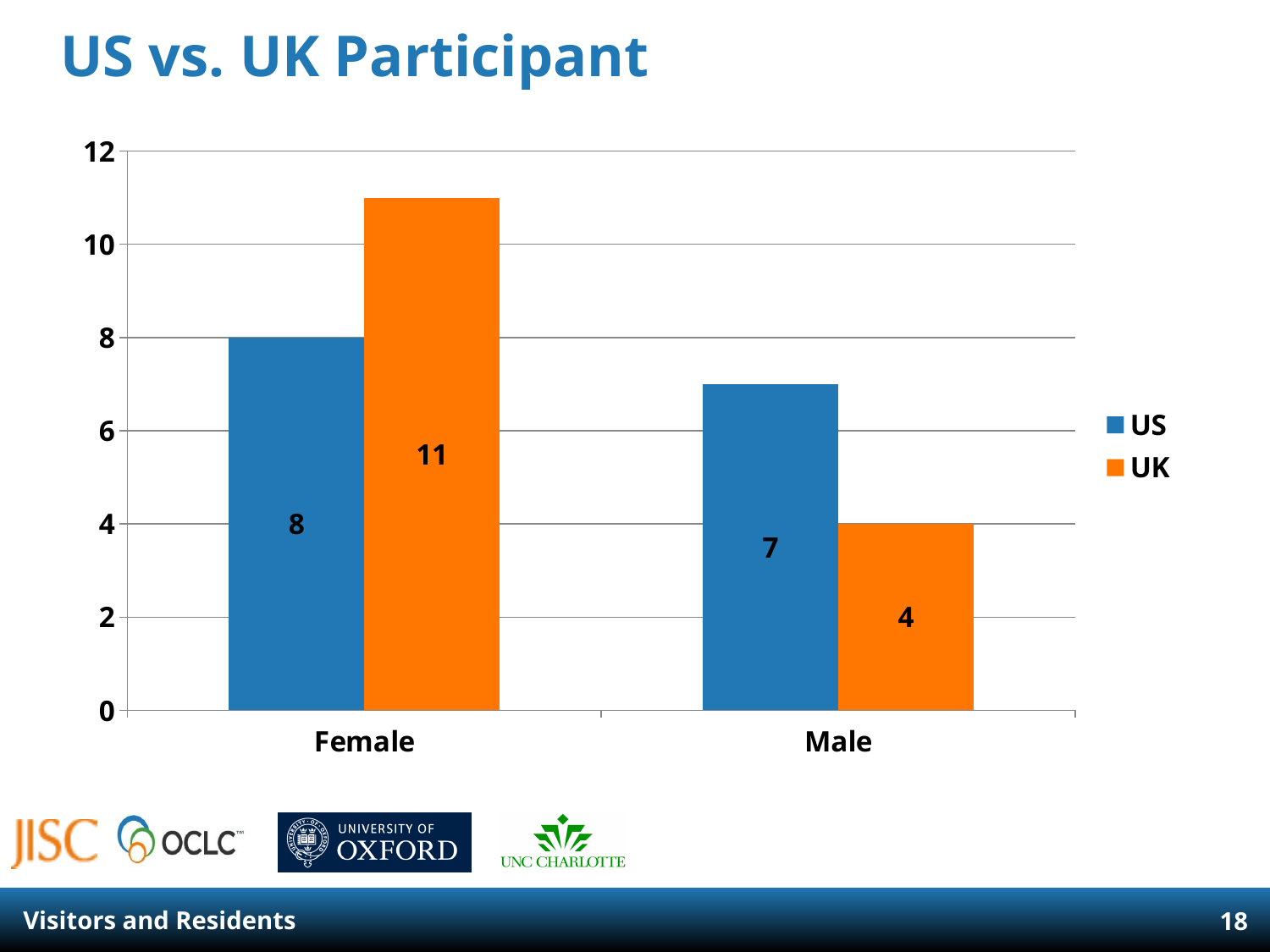
Which bar has the highest value on the chart? UK Female What is the value for US Male participants? 7 What is the difference between the UK Female and US Female values? 3 How many categories are shown on the x axis? 2 What kind of chart is shown on the slide? Bar chart What is the value for US Female participants? 8 Which bar has the lowest value on the chart? UK Male How many series does the legend list? 2 What is the difference between the US Male and UK Male values? 3 What is the value for UK Male participants? 4 What is the value for UK Female participants? 11 Which is larger, the US Male value or the UK Male value? US Male